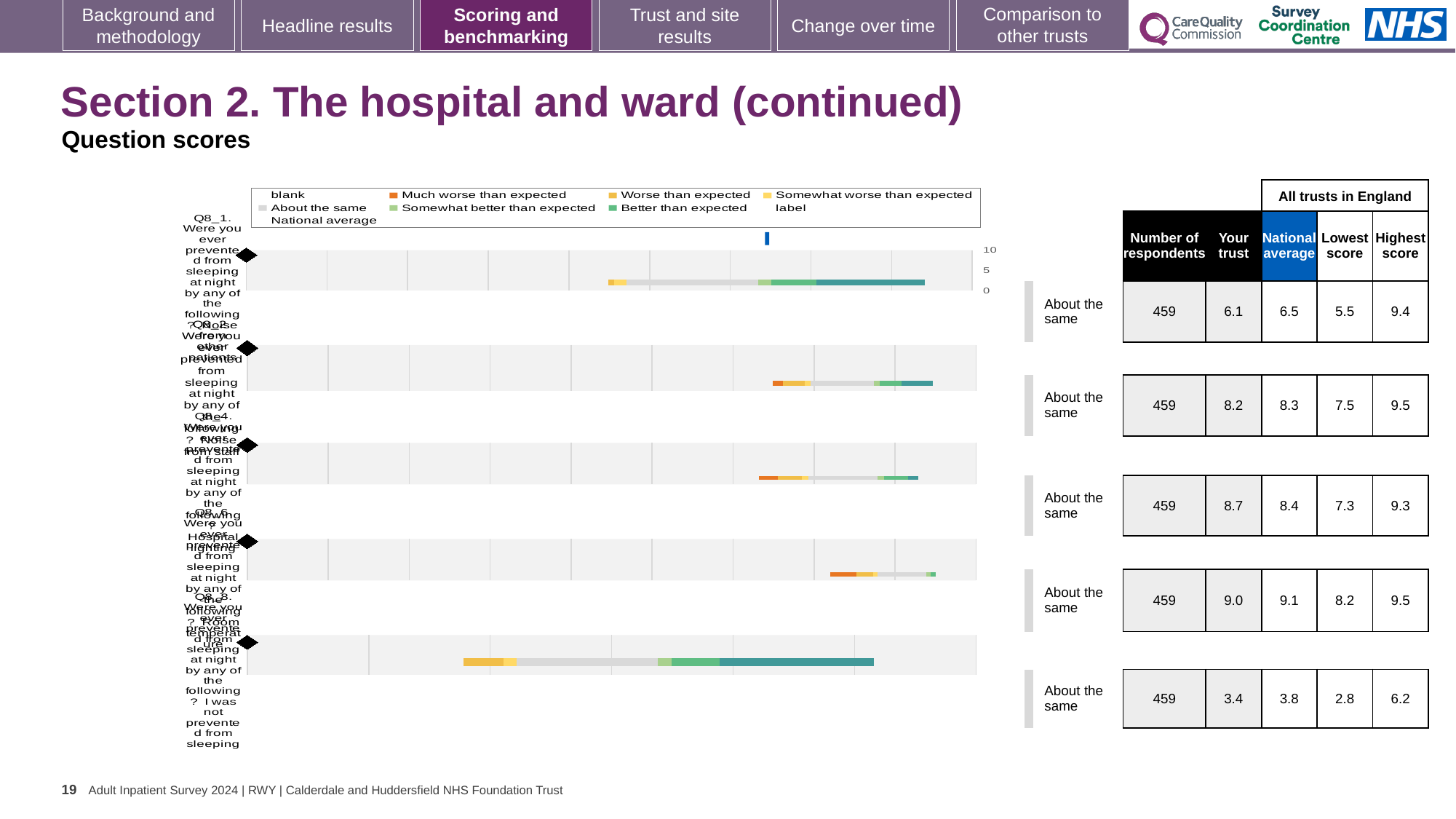
How many question rows (bars) does the chart show? 5 For the first row, which is larger: the 'Your trust' score or the national average? National average Which row has the lowest 'Your trust' score in the table beside the chart? the last row (3.4) What is the maximum value shown on the chart's horizontal axis? 10 Which row has the highest 'Your trust' score in the table beside the chart? the fourth row (9.0) What is the difference between the highest and lowest 'Your trust' scores in the table (9.0 and 3.4)? 5.6 In the table beside the chart, what is the highest score for the last row? 6.2 In the table beside the chart, what is the 'Your trust' score for the first row? 6.1 In the table beside the chart, how many respondents are listed for each row? 459 In the table beside the chart, what is the national average for the first row? 6.5 Which legend entry is shown in dark orange on the chart? Much worse than expected What kind of chart is shown on the slide? bar chart